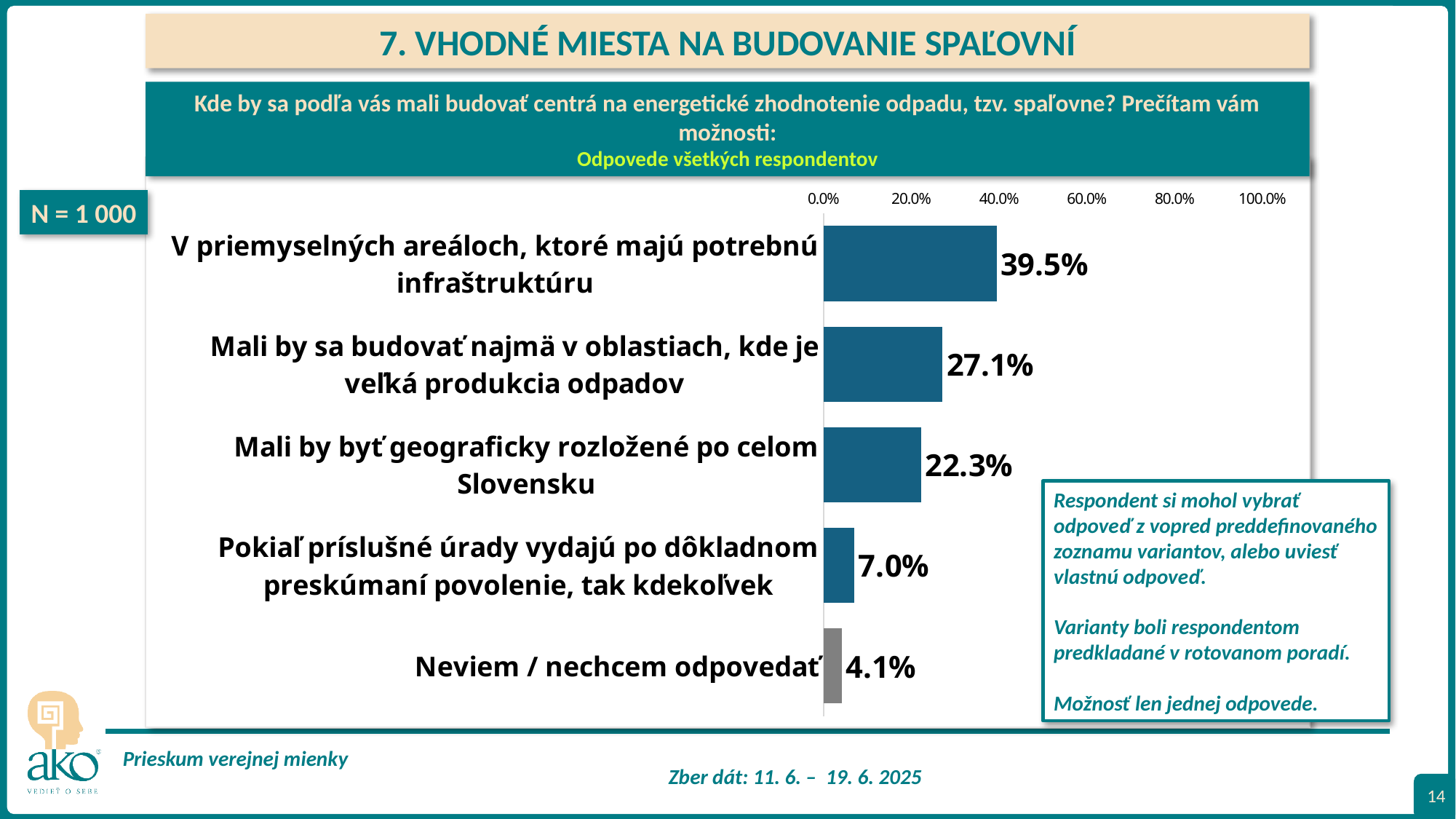
What is the value for 'Mali by sa budovať najmä v oblastiach, kde je veľká produkcia odpadov'? 27.1% Is the value for 'V priemyselných areáloch, ktoré majú potrebnú infraštruktúru' greater or less than 40.0%? less How many categories are shown in the chart? 5 What is the value for 'V priemyselných areáloch, ktoré majú potrebnú infraštruktúru'? 39.5% What is the value for 'Neviem / nechcem odpovedať'? 4.1% Which category has the highest value? V priemyselných areáloch, ktoré majú potrebnú infraštruktúru What is the difference between the values for 'V priemyselných areáloch, ktoré majú potrebnú infraštruktúru' and 'Mali by sa budovať najmä v oblastiach, kde je veľká produkcia odpadov'? 12.4% Which category has the lowest value? Neviem / nechcem odpovedať What is the value for 'Mali by byť geograficky rozložené po celom Slovensku'? 22.3% What kind of chart is shown on the slide? bar chart Which is larger: the value for 'Mali by byť geograficky rozložené po celom Slovensku' or for 'Pokiaľ príslušné úrady vydajú po dôkladnom preskúmaní povolenie, tak kdekoľvek'? Mali by byť geograficky rozložené po celom Slovensku What is the sample size (N) shown on the slide? N = 1 000